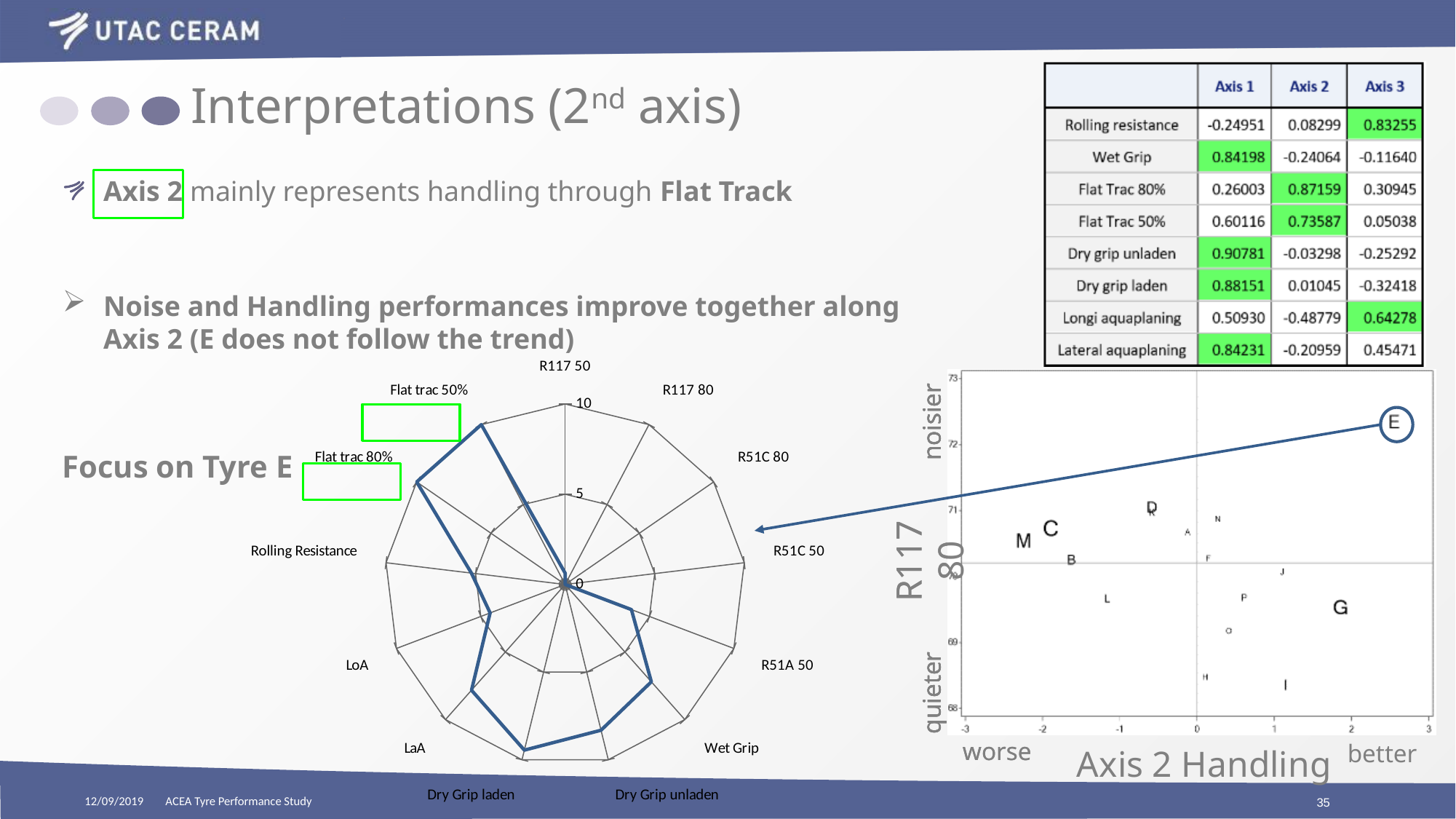
On the radar chart on the left, what is the maximum value shown on the radial axis? 10 On the radar chart on the left, is the value for R51C 50 greater or less than 5? less On the radar chart on the left, is the value for Wet Grip greater or less than 5? greater On the scatter plot on the right, which tyre has the lowest R117 80 value? I What is the title of the horizontal axis of the scatter plot on the right? Axis 2 Handling On the scatter plot on the right, which tyre has the highest R117 80 value? E How many categories (spokes) does the radar chart on the left have? 13 On the scatter plot on the right, is the R117 80 value for tyre E greater or less than 72? greater What kind of chart is the chart on the left of the slide? radar chart What kind of chart is the chart on the right of the slide? scatter plot